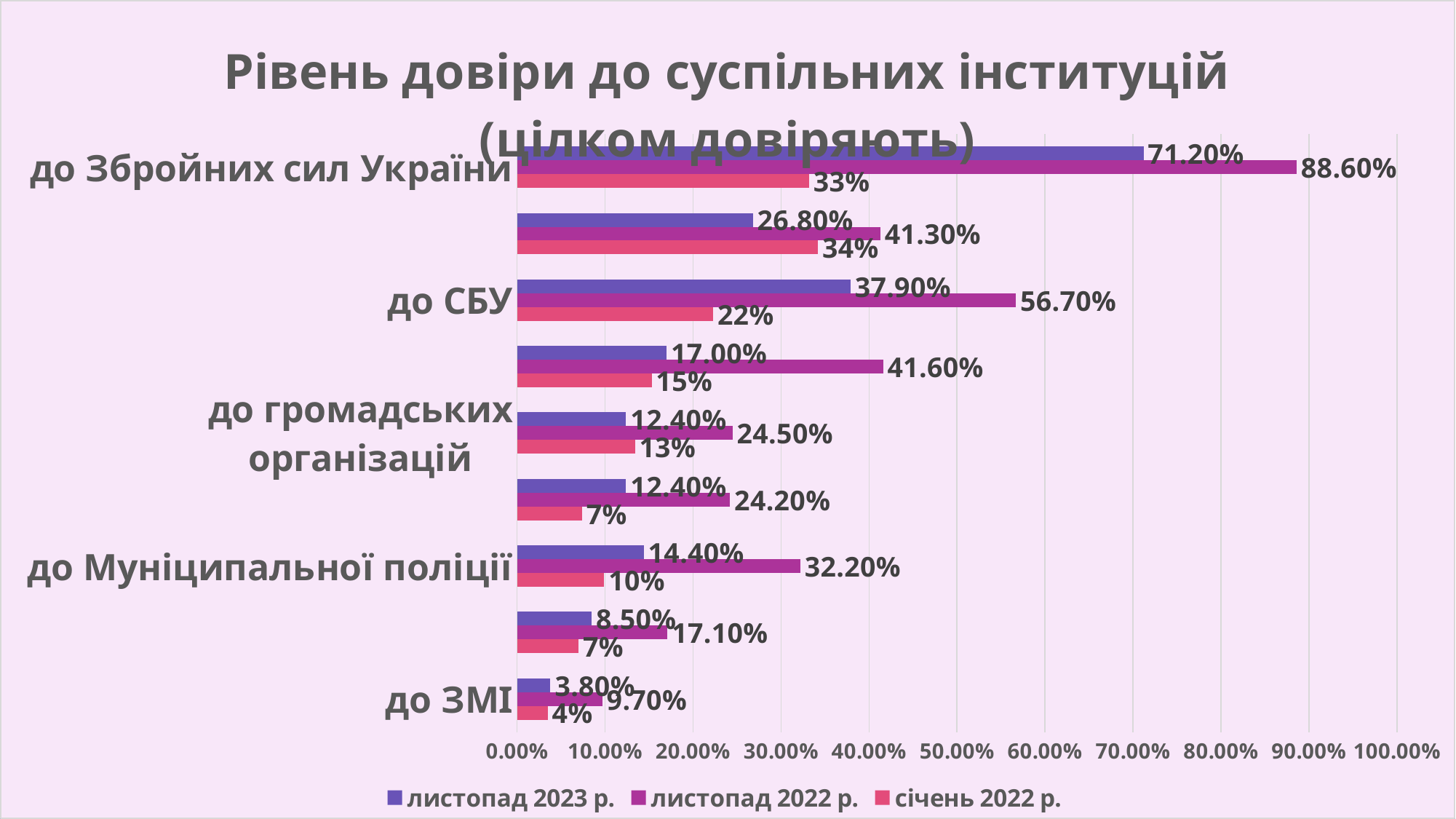
Which category has the lowest value in the листопад 2023 р. series? до ЗМІ What is the value for до Муніципальної поліції in the листопад 2022 р. series? 32.20% What is the value for до Збройних сил України in the листопад 2022 р. series? 88.60% For до СБУ, which series has the larger value: листопад 2023 р. or січень 2022 р.? листопад 2023 р. What is the title of the chart? Рівень довіри до суспільних інституцій (цілком довіряють) For до СБУ, what is the difference between the листопад 2022 р. value and the листопад 2023 р. value? 18.80% What kind of chart is shown on the slide? bar chart How many series does the legend list? 3 What is the value for до ЗМІ in the січень 2022 р. series? 4% For до Збройних сил України, what is the difference between the листопад 2022 р. value and the листопад 2023 р. value? 17.40% What is the value for до СБУ in the листопад 2023 р. series? 37.90% Which category has the highest value in the листопад 2022 р. series? до Збройних сил України